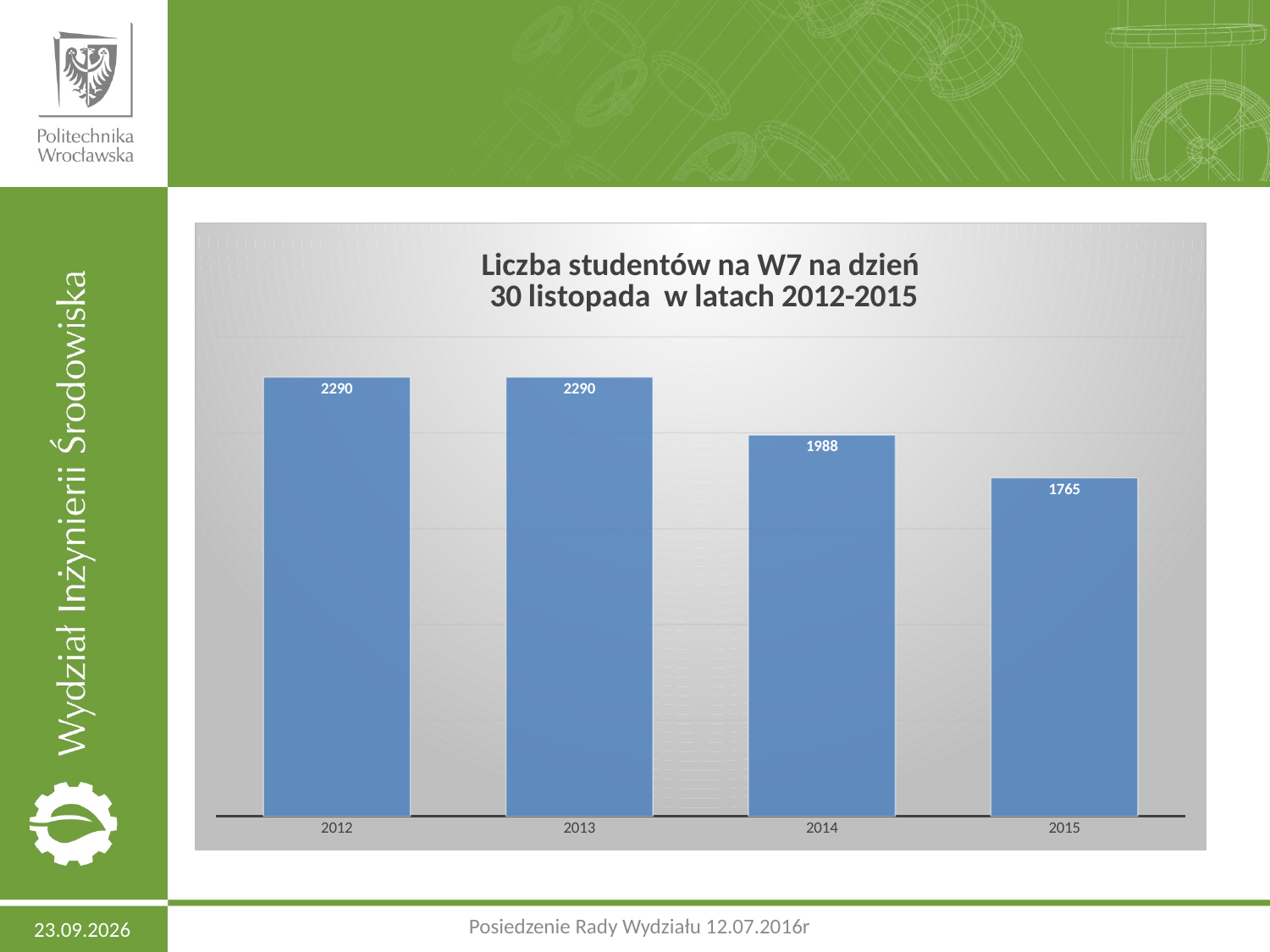
What is the difference between the values for 2013 and 2014? 302 What is the title of the chart? Liczba studentów na W7 na dzień 30 listopada w latach 2012-2015 What is the number of students shown for 2015? 1765 What is the difference between the values for 2014 and 2015? 223 Which year has the lowest number of students? 2015 What is the number of students shown for 2012? 2290 What is the number of students shown for 2014? 1988 Which is larger, the value for 2014 or the value for 2015? 2014 Are the values for 2012 and 2013 the same? yes Do the values rise or fall from 2013 to 2015? fall How many years are shown on the x axis? 4 What kind of chart is shown on the slide? bar chart